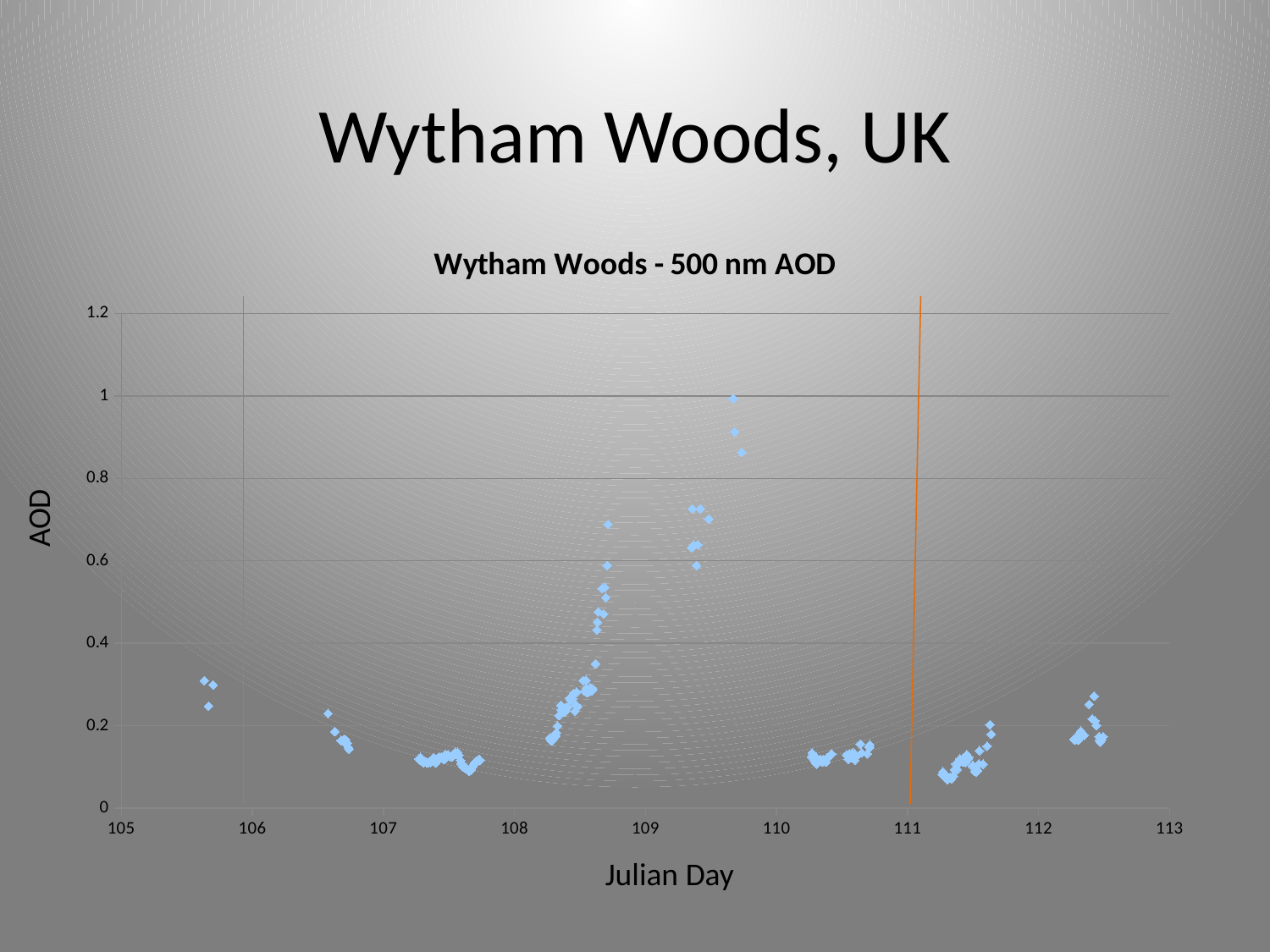
Which is higher: the AOD values plotted near Julian Day 109.4 or those near Julian Day 107.5? near Julian Day 109.4 What is the title of the chart? Wytham Woods - 500 nm AOD Is the highest AOD value plotted near Julian Day 108.7 greater or less than 0.6? greater What kind of chart is shown on the slide? Scatter chart Are the AOD values plotted around Julian Day 110.5 greater or less than 0.4? less Around which Julian Day does the chart reach its highest AOD value: near 109.7 or near 112.4? near 109.7 Are the AOD values plotted around Julian Day 107.5 greater or less than 0.2? less What is the label of the x axis of the chart? Julian Day